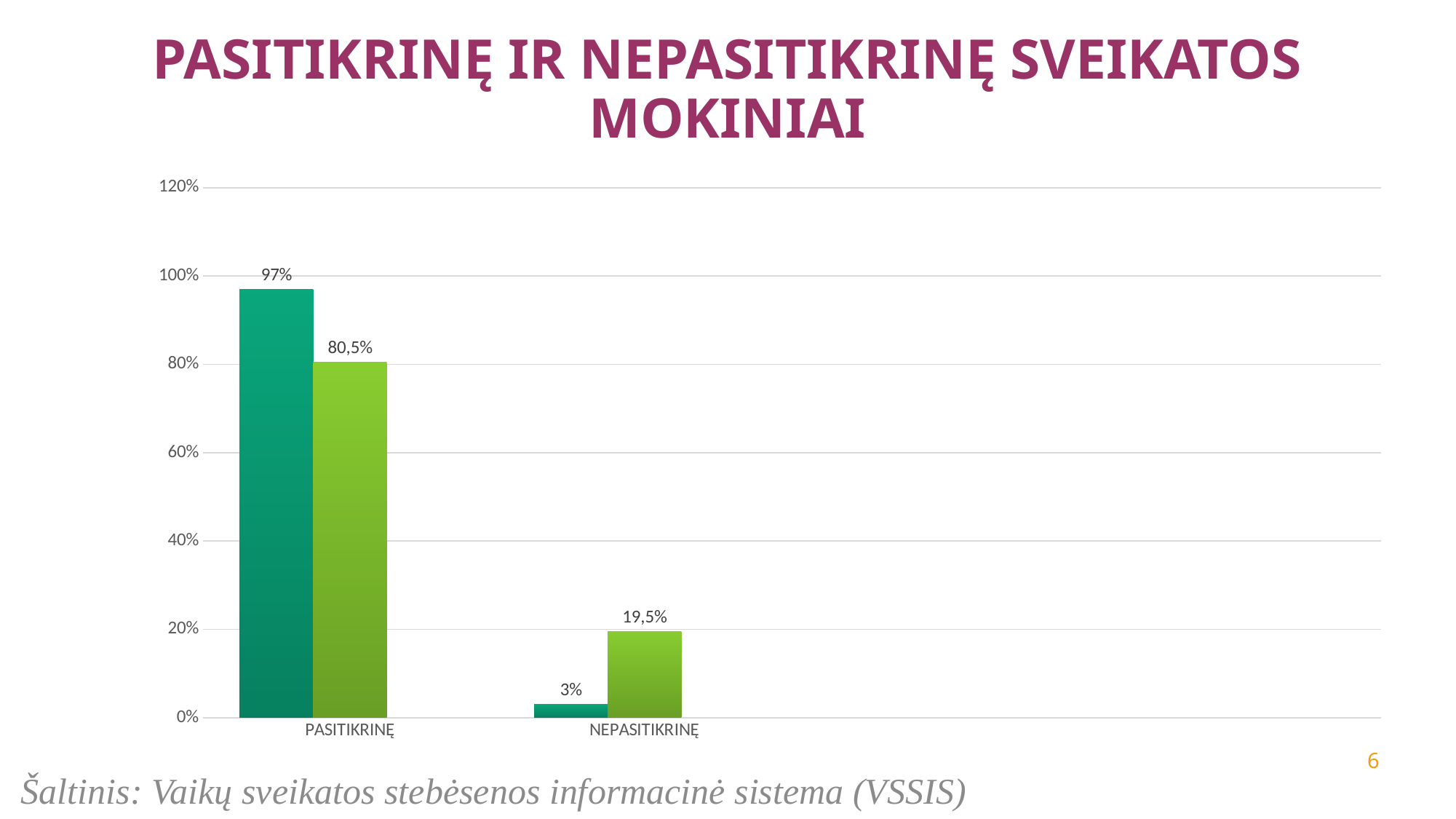
What is the difference between the teal bars for PASITIKRINĘ and NEPASITIKRINĘ? 94% What kind of chart is shown on the slide? bar chart What is the difference between the green bars for PASITIKRINĘ and NEPASITIKRINĘ? 61% How many categories are shown on the x axis of the chart? 2 Which category has the highest bar in the chart? PASITIKRINĘ For NEPASITIKRINĘ, which bar is larger, the teal one or the green one? the green one What is the value of the green bar for NEPASITIKRINĘ? 19,5% What is the value of the teal bar for PASITIKRINĘ? 97% What is the value of the teal bar for NEPASITIKRINĘ? 3% What is the value of the green bar for PASITIKRINĘ? 80,5% Which bar is the lowest in the chart? the teal bar for NEPASITIKRINĘ (3%) What is the title of the chart on the slide? PASITIKRINĘ IR NEPASITIKRINĘ SVEIKATOS MOKINIAI